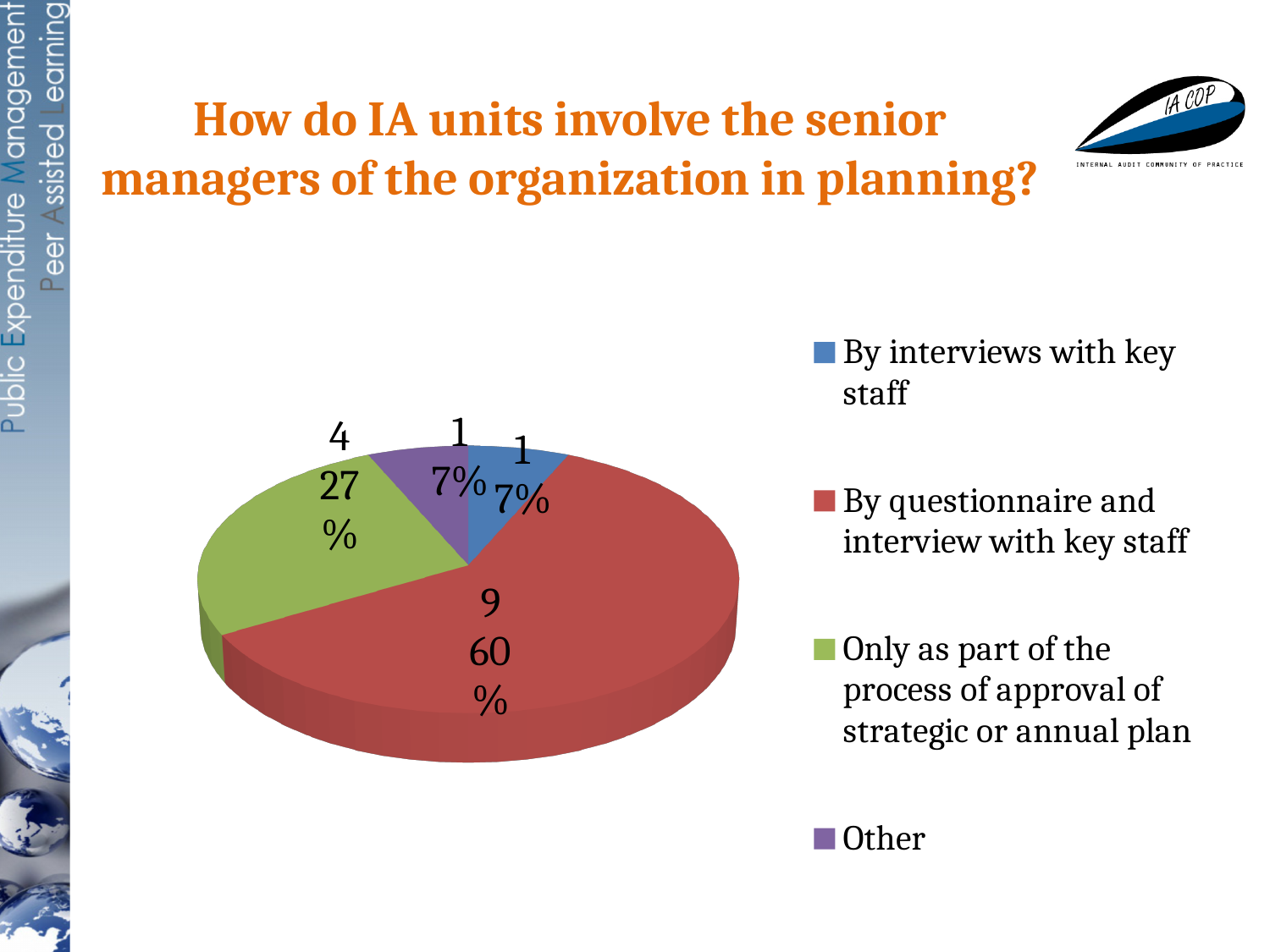
What is the difference in count between 'By questionnaire and interview with key staff' and 'Only as part of the process of approval of strategic or annual plan'? 5 What count is shown for 'By questionnaire and interview with key staff'? 9 What percentage is shown for 'Only as part of the process of approval of strategic or annual plan'? 27% How many entries does the legend list? 4 What colour is the slice for 'Other'? Purple Which is larger: the share for 'Only as part of the process of approval of strategic or annual plan' or the share for 'Other'? Only as part of the process of approval of strategic or annual plan What count is shown for 'Other'? 1 What kind of chart is shown on the slide? Pie chart What percentage is shown for 'By interviews with key staff'? 7% What is the total count across all slices of the pie? 15 How many slices does the pie chart have? 4 Which category has the largest share of the pie? By questionnaire and interview with key staff